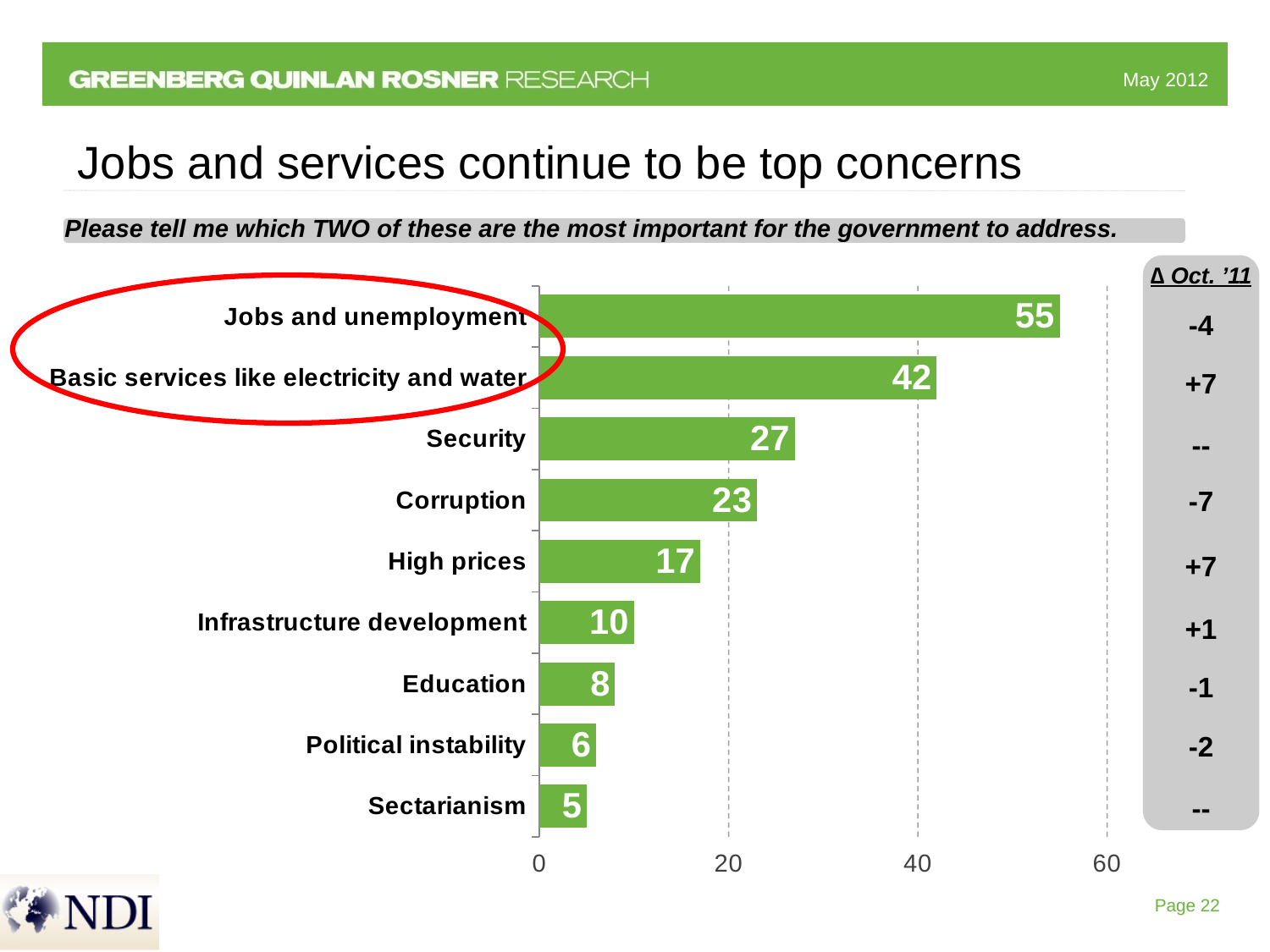
What is the value for Corruption? 23 Which category has the highest value? Jobs and unemployment What is the value for Political instability? 6 Is the value for Security greater or less than 20? greater Which is larger, the value for Corruption or the value for Infrastructure development? Corruption How many categories are shown in the chart? 9 Which category has the lowest value? Sectarianism What is the difference between the values for Jobs and unemployment and Basic services like electricity and water? 13 What is the value for Basic services like electricity and water? 42 What is the value for Jobs and unemployment? 55 What is the difference between the values for Security and High prices? 10 What kind of chart is shown on the slide? Bar chart